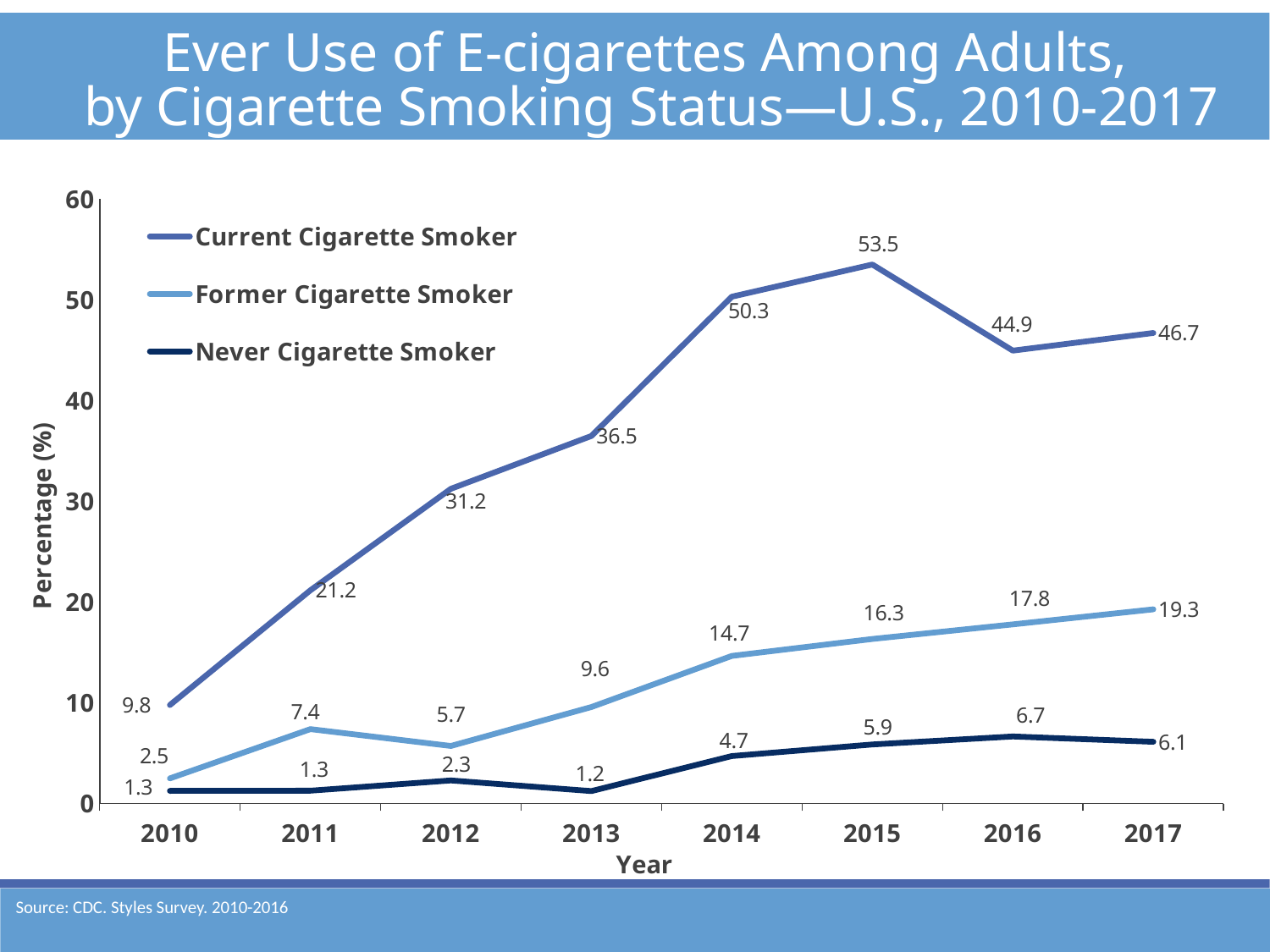
In which year is the Never Cigarette Smoker value lowest? 2013 How many series does the legend list? 3 In which year is the Current Cigarette Smoker value highest? 2015 Is the value for Current Cigarette Smoker in 2014 greater or less than 50? greater What kind of chart is shown on the slide? Line chart Does the Former Cigarette Smoker series rise or fall from 2013 to 2017? Rise Which is larger: the Former Cigarette Smoker value in 2012 or in 2011? 2011 How many years are plotted on the x axis? 8 What is the value for Current Cigarette Smoker in 2015? 53.5 What is the value for Never Cigarette Smoker in 2017? 6.1 What is the difference between the Current Cigarette Smoker value in 2017 and the Former Cigarette Smoker value in 2017? 27.4 What is the value for Former Cigarette Smoker in 2013? 9.6